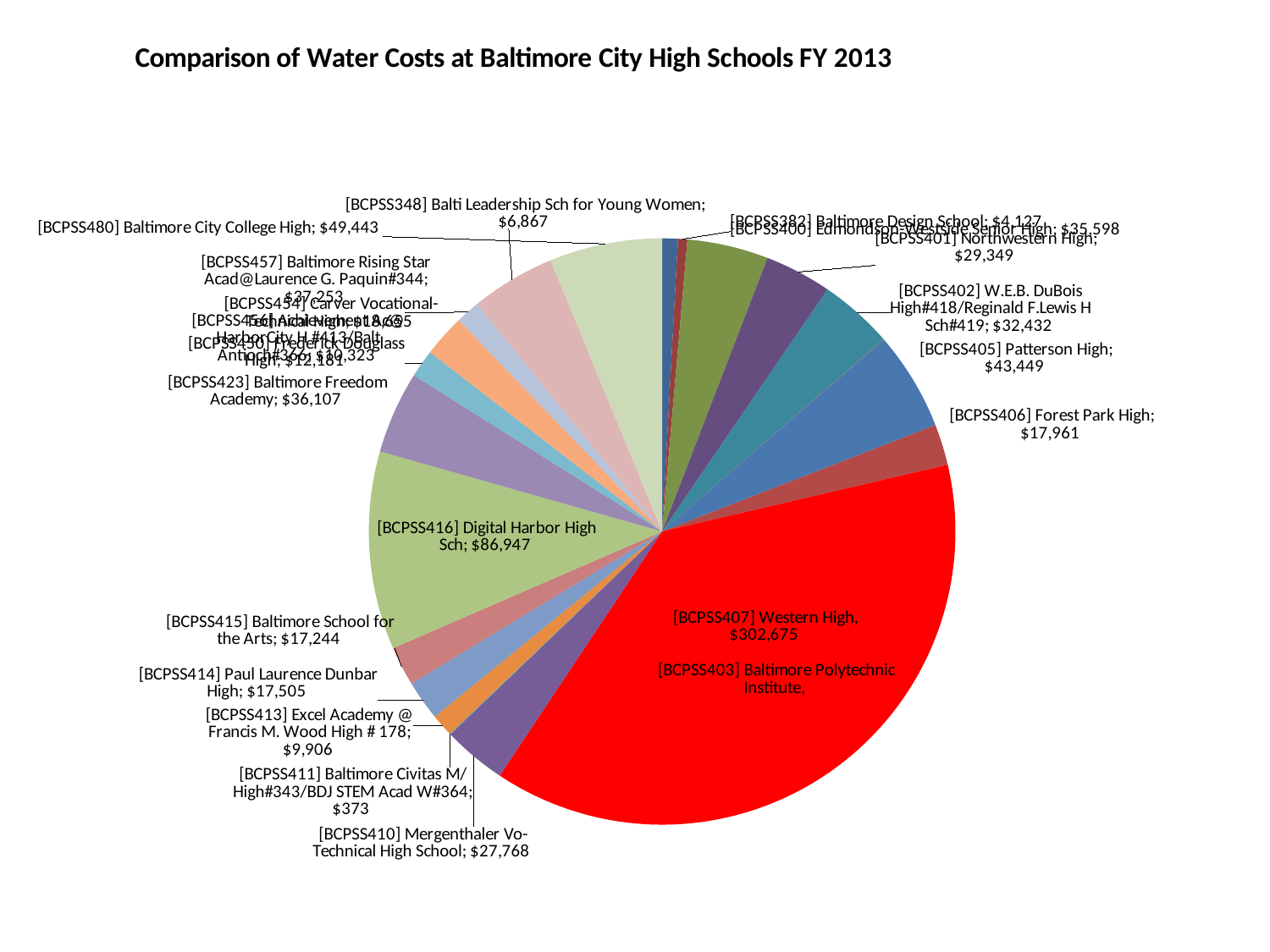
What is the water cost shown for [BCPSS411] Baltimore Civitas M/High#343/BDJ STEM Acad W#364? $373 What is the water cost shown for [BCPSS416] Digital Harbor High Sch? $86,947 What kind of chart is shown on the slide? pie chart What is the water cost shown for [BCPSS405] Patterson High? $43,449 Which has a higher water cost, [BCPSS416] Digital Harbor High Sch or [BCPSS480] Baltimore City College High? [BCPSS416] Digital Harbor High Sch What is the water cost shown for [BCPSS410] Mergenthaler Vo-Technical High School? $27,768 What is the difference in water cost between [BCPSS406] Forest Park High and [BCPSS414] Paul Laurence Dunbar High? $456 What is the difference in water cost between [BCPSS480] Baltimore City College High and [BCPSS405] Patterson High? $5,994 What is the title of the chart? Comparison of Water Costs at Baltimore City High Schools FY 2013 What is the water cost shown for [BCPSS480] Baltimore City College High? $49,443 What is the water cost shown for [BCPSS382] Baltimore Design School? $4,127